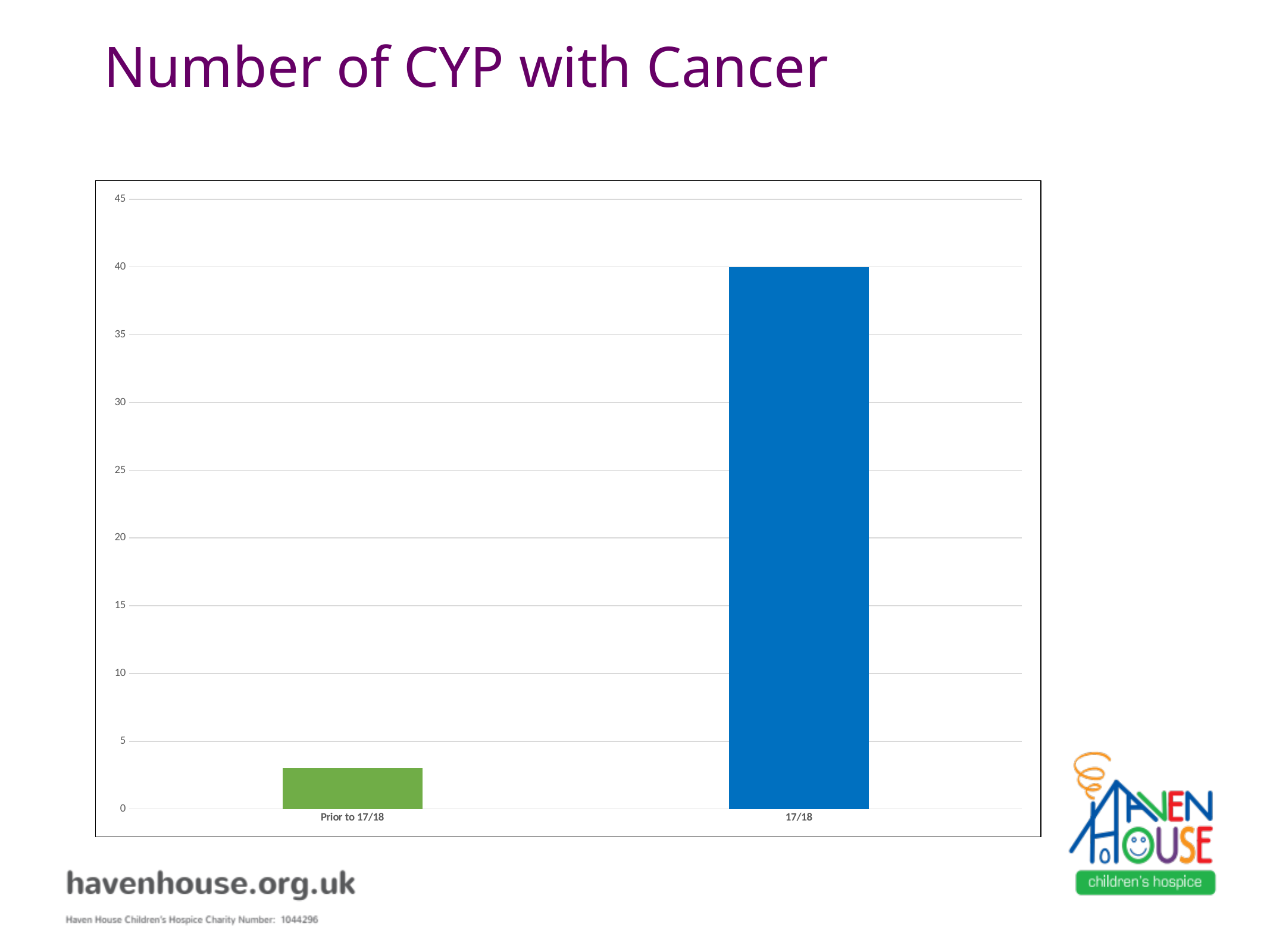
Is the value for Prior to 17/18 greater or less than 5? less What kind of chart is shown on the slide? bar chart Which is larger, the value for Prior to 17/18 or the value for 17/18? 17/18 What is the highest value shown on the y axis of the chart? 45 Is the value for 17/18 greater or less than 35? greater What is the title of the slide containing the chart? Number of CYP with Cancer Which category has the lowest value in the chart? Prior to 17/18 Do the values rise or fall from Prior to 17/18 to 17/18? rise What colour is the bar for 17/18? blue What is the value for 17/18 in the chart? 40 Which category has the highest value in the chart? 17/18 How many categories are shown on the x axis of the chart? 2